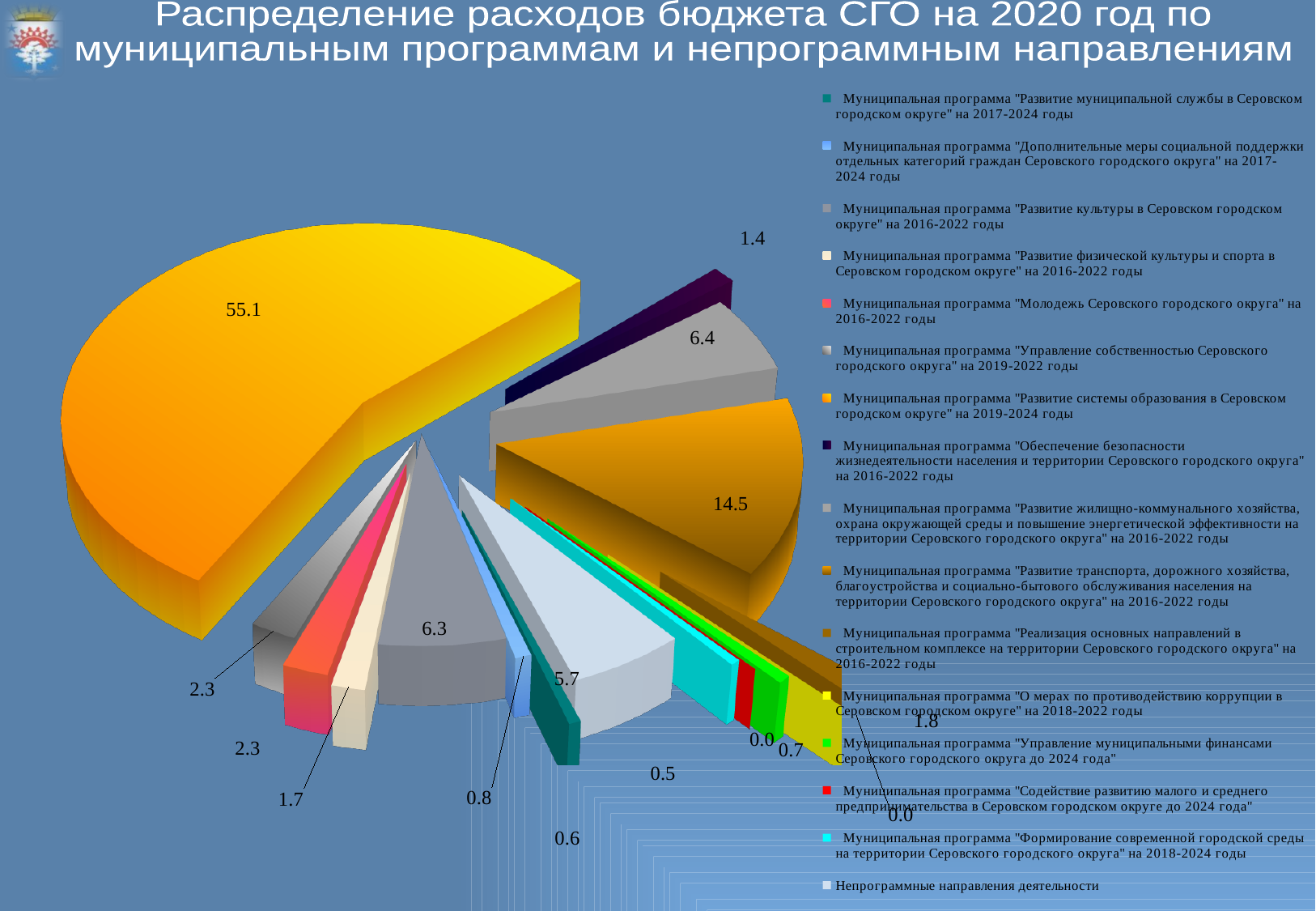
What is the smallest value shown on the pie chart? 0.0 What is the value for the program "Развитие системы образования в Серовском городском округе" на 2019-2024 годы? 55.1 What is the value for the program "Обеспечение безопасности жизнедеятельности населения и территории Серовского городского округа"? 1.4 What is the difference between the largest slice (55.1) and the second largest slice (14.5)? 40.6 What is the value for the program "Развитие транспорта, дорожного хозяйства, благоустройства и социально-бытового обслуживания населения"? 14.5 What kind of chart is shown on the slide? pie chart Which is larger: the slice for the education program or the slice for the transport program? the education program (55.1) Which legend entry corresponds to the largest (yellow) slice of the pie? Муниципальная программа "Развитие системы образования в Серовском городском округе" на 2019-2024 годы What is the largest value shown on the pie chart? 55.1 How many entries does the chart legend list? 16 What is the value for "Непрограммные направления деятельности"? 5.7 How many data labels (slices) are shown on the pie chart? 16